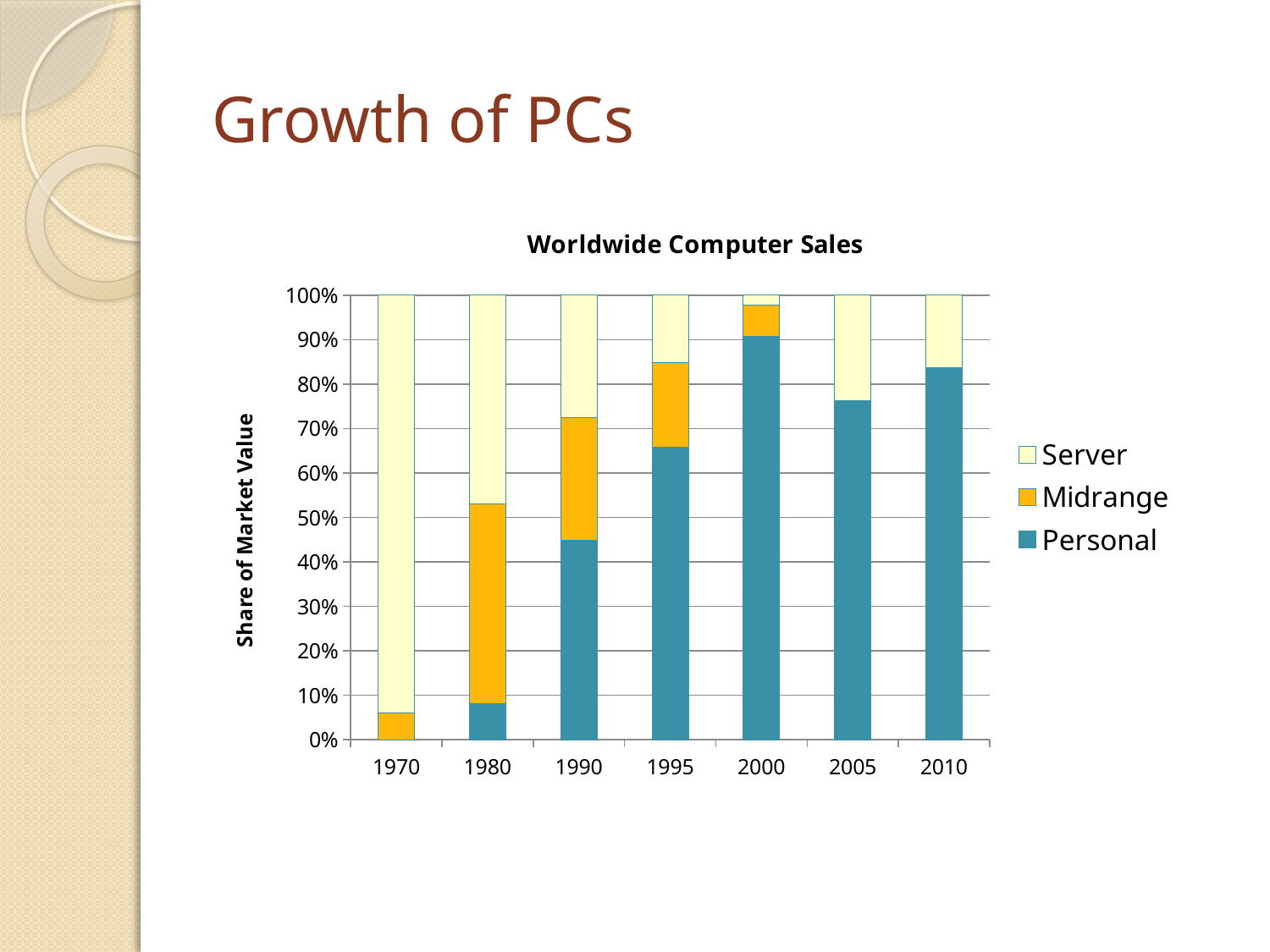
In which year is the Server share of market value the largest? 1970 Which year has the larger Personal share, 2005 or 2010? 2010 In which year is the Personal share of market value the largest? 2000 How many series does the chart's legend list? 3 What is the label on the vertical axis of the chart? Share of Market Value Is the Personal share in 1980 greater or less than 20%? less Is the Personal share in 2000 greater or less than 80%? greater What is the title of the chart? Worldwide Computer Sales Is the Midrange share in 1980 greater or less than 30%? greater What kind of chart is shown on the slide? Stacked bar chart How many years are shown on the x axis of the chart? 7 In which year is the Server share of market value the smallest? 2000